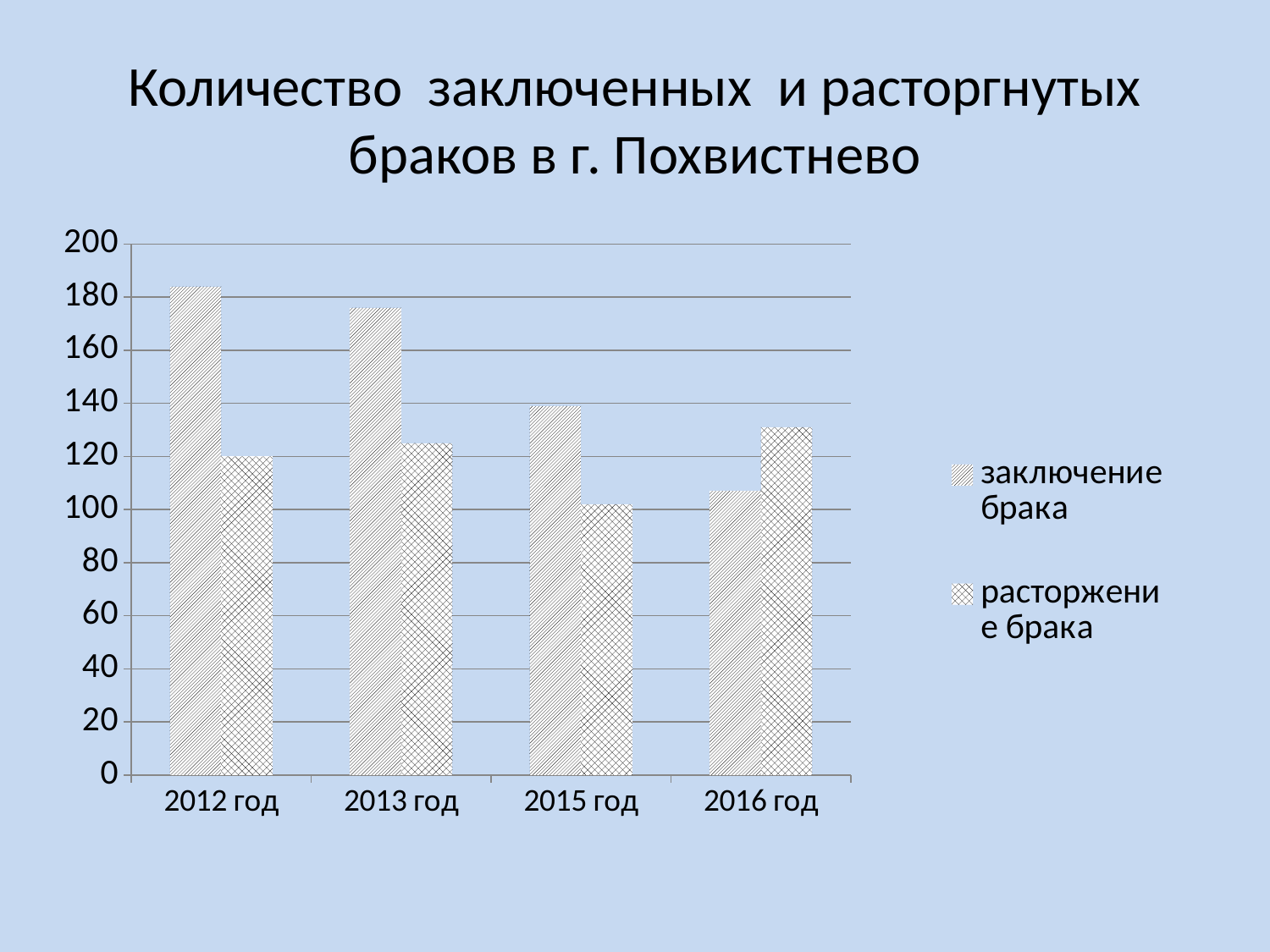
What kind of chart is shown on the slide? bar chart How many year categories are shown on the x axis? 4 How many series does the legend list? 2 In which year is the value for заключение брака the highest? 2012 год What is the title of the chart? Количество заключенных и расторгнутых браков в г. Похвистнево Is the value for заключение брака in 2012 год greater or less than 160? greater Is the value for заключение брака in 2016 год greater or less than 120? less Is the value for расторжение брака in 2016 год greater or less than 120? greater In which year is the value for расторжение брака the lowest? 2015 год In 2016 год, which is larger: заключение брака or расторжение брака? расторжение брака In which year is the value for заключение брака the lowest? 2016 год Does the value for заключение брака rise or fall from 2012 год to 2016 год? fall